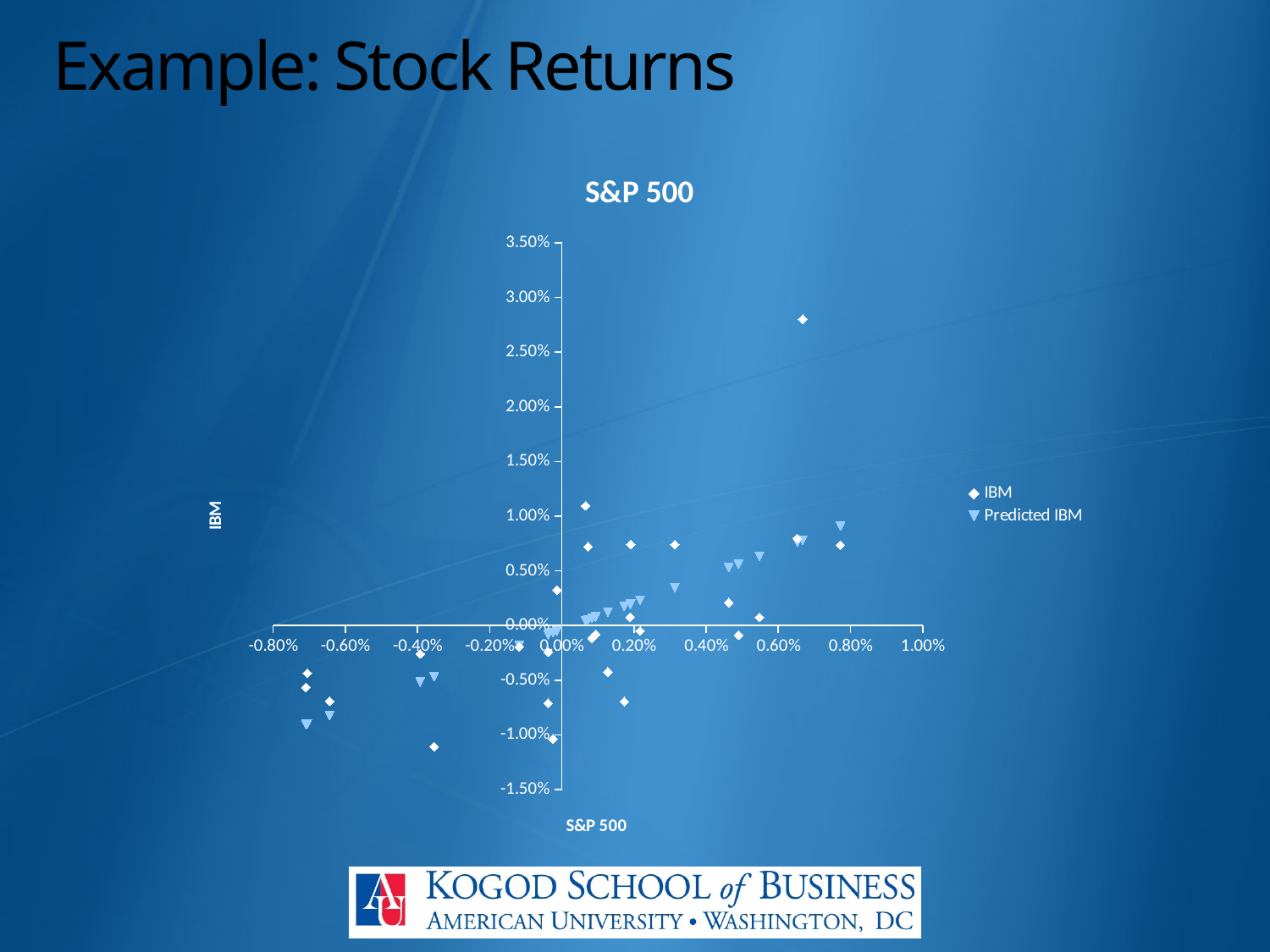
Do the Predicted IBM values rise or fall as the S&P 500 value increases along the x axis? rise What are the two series named in the chart's legend? IBM and Predicted IBM What kind of chart is shown on the slide? scatter chart Which series reaches the higher maximum value on the chart, IBM or Predicted IBM? IBM Is the highest IBM value on the chart greater or less than 2.50%? greater How many series does the chart's legend list? 2 Is the highest Predicted IBM value on the chart greater or less than 1.50%? less Is the lowest IBM value on the chart greater or less than -1.00%? less What is the title of the chart? S&P 500